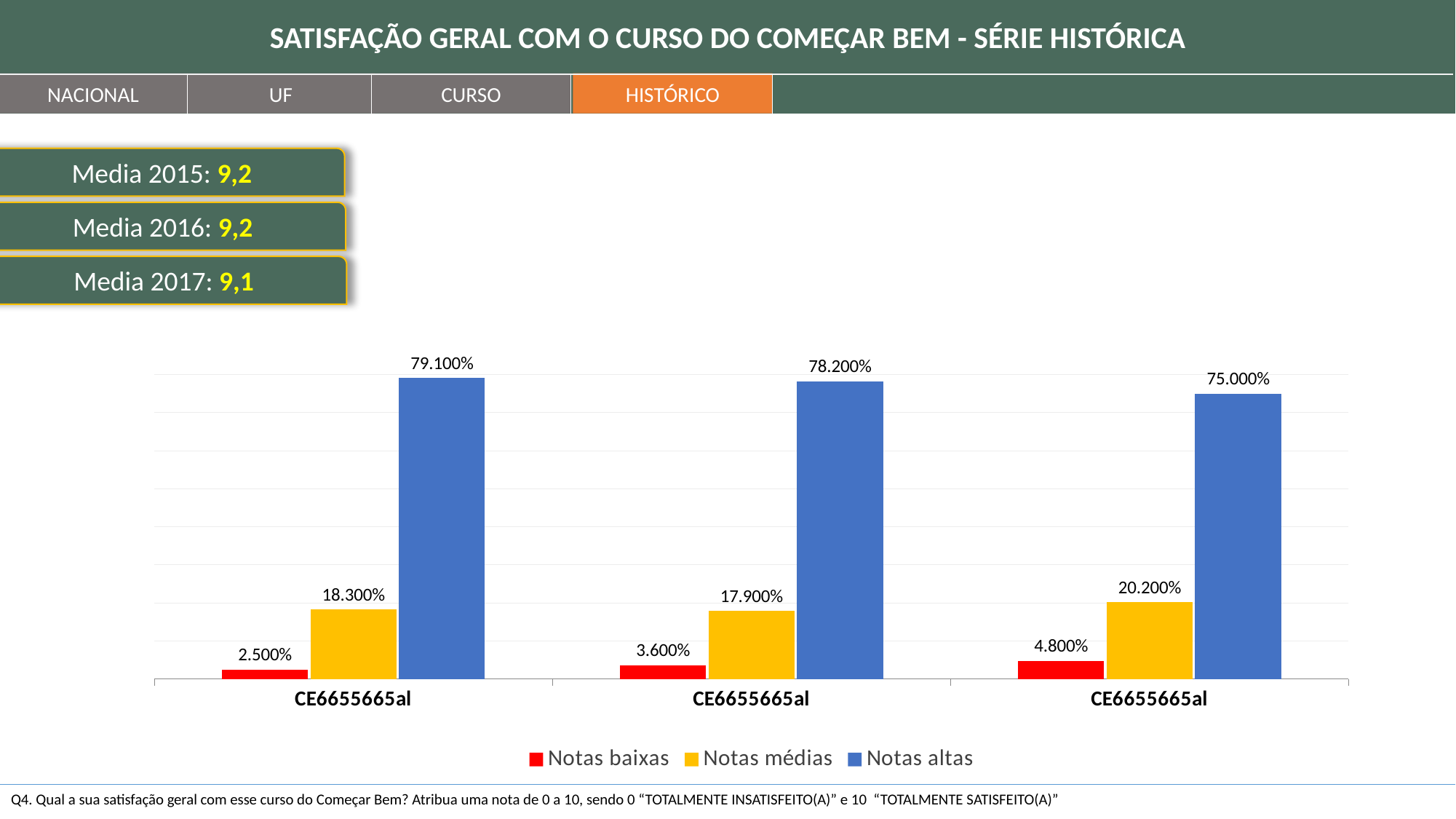
How many groups of bars are plotted along the x axis? 3 What is the value of Notas baixas in the middle group of bars? 3.600% Which group of bars (left, middle or right) has the lowest Notas baixas value? left What is the difference between the Notas altas value in the leftmost group and the Notas altas value in the rightmost group? 4.100% Which group of bars (left, middle or right) has the highest Notas altas value? left What colour are the Notas altas bars? blue What kind of chart is shown on the slide? bar chart What is the value of Notas médias in the rightmost group of bars? 20.200% How many series does the chart legend list? 3 Which is larger: Notas médias in the leftmost group or Notas médias in the middle group? Notas médias in the leftmost group What is the value of Notas altas in the leftmost group of bars? 79.100% Do the Notas baixas values rise or fall from the left group to the right group? rise